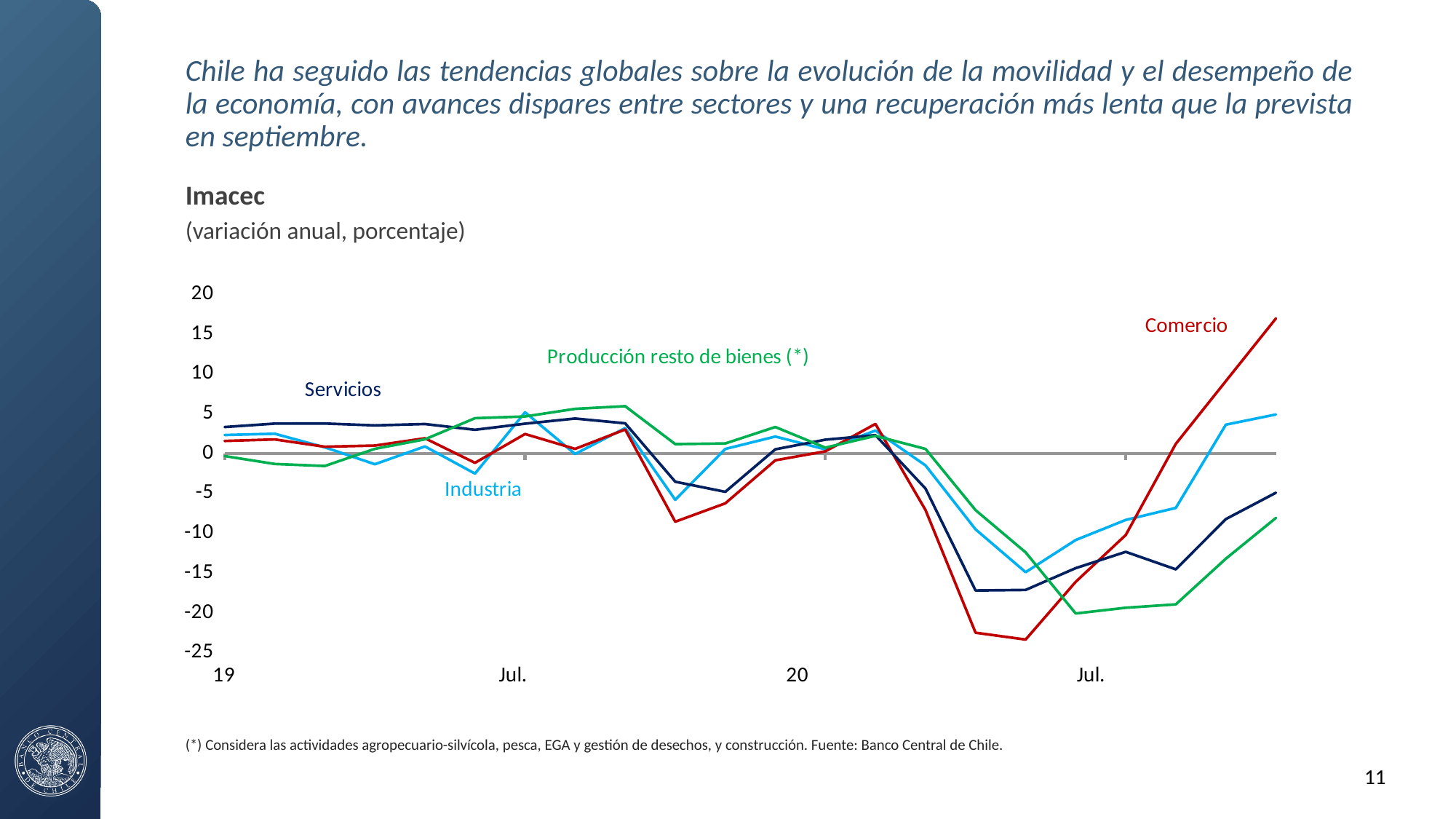
Which series falls to the lowest point anywhere in the chart? Comercio How many series are plotted in the Imacec chart? 4 Does the Comercio line rise or fall between the second 'Jul.' tick and the end of the chart? rise Is the lowest value of Comercio greater or less than -20? less What kind of chart is shown on the slide? line chart Is the lowest value of Servicios greater or less than -15? less Is the final value of Comercio greater or less than 15? greater At the right end of the chart, which is larger: Comercio or Industria? Comercio What colour is the line for Producción resto de bienes (*)? green What is the title of the chart? Imacec Which series reaches the highest value at the right end of the chart? Comercio